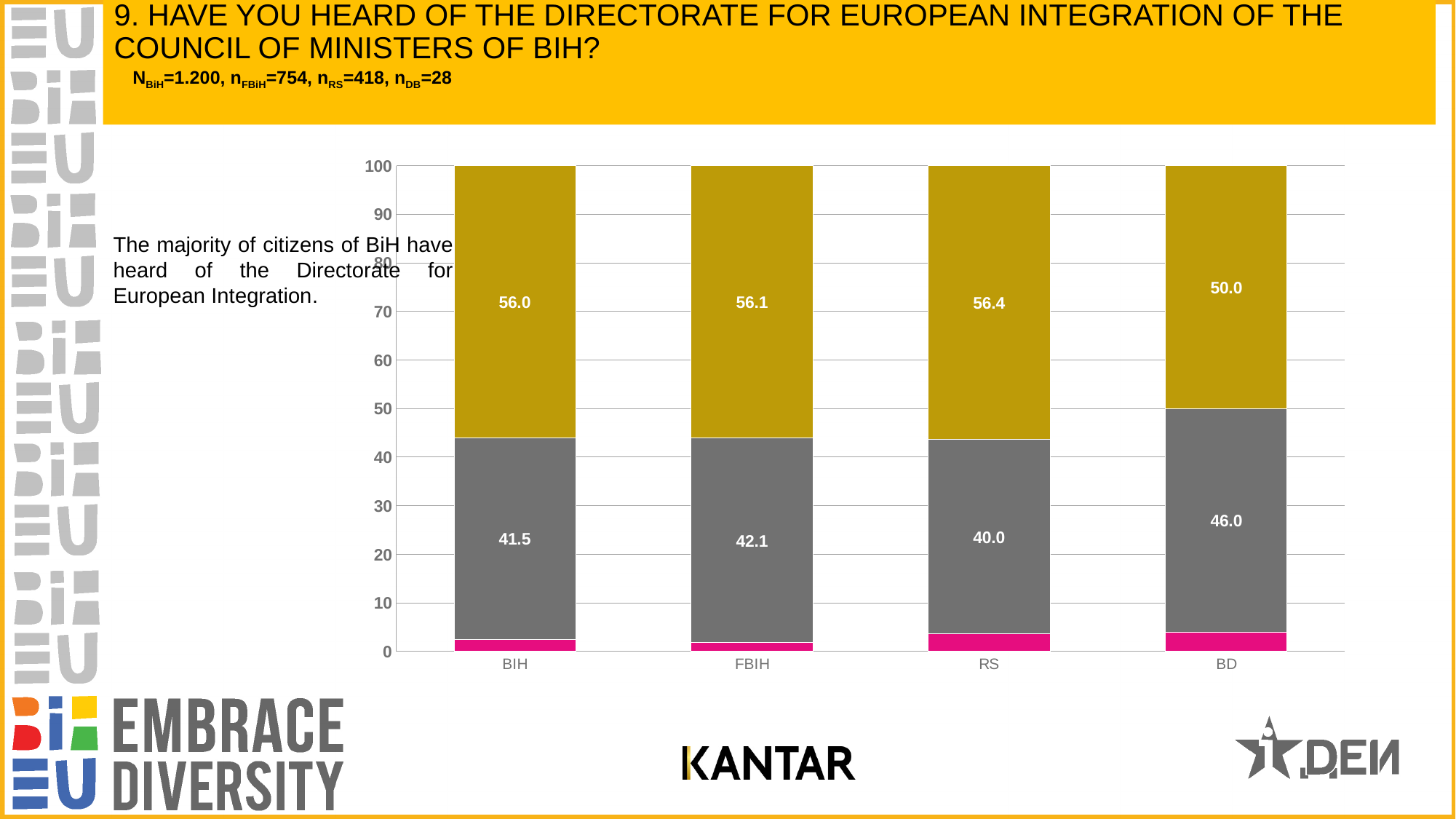
Is the value of the pink segment for RS greater or less than 10? less How many categories are shown on the x axis? 4 Which category has the highest value for the gold segment? RS What is the value of the grey segment for BD? 46.0 What is the value of the gold segment for RS? 56.4 What is the value of the gold segment for BIH? 56.0 What kind of chart is shown on the slide? stacked bar chart What is the value of the grey segment for FBIH? 42.1 Which category has the lowest value for the gold segment? BD What is the difference between the gold and grey segment values for BIH? 14.5 Which category has the highest value for the grey segment? BD Which is larger for BD, the gold segment or the grey segment? the gold segment